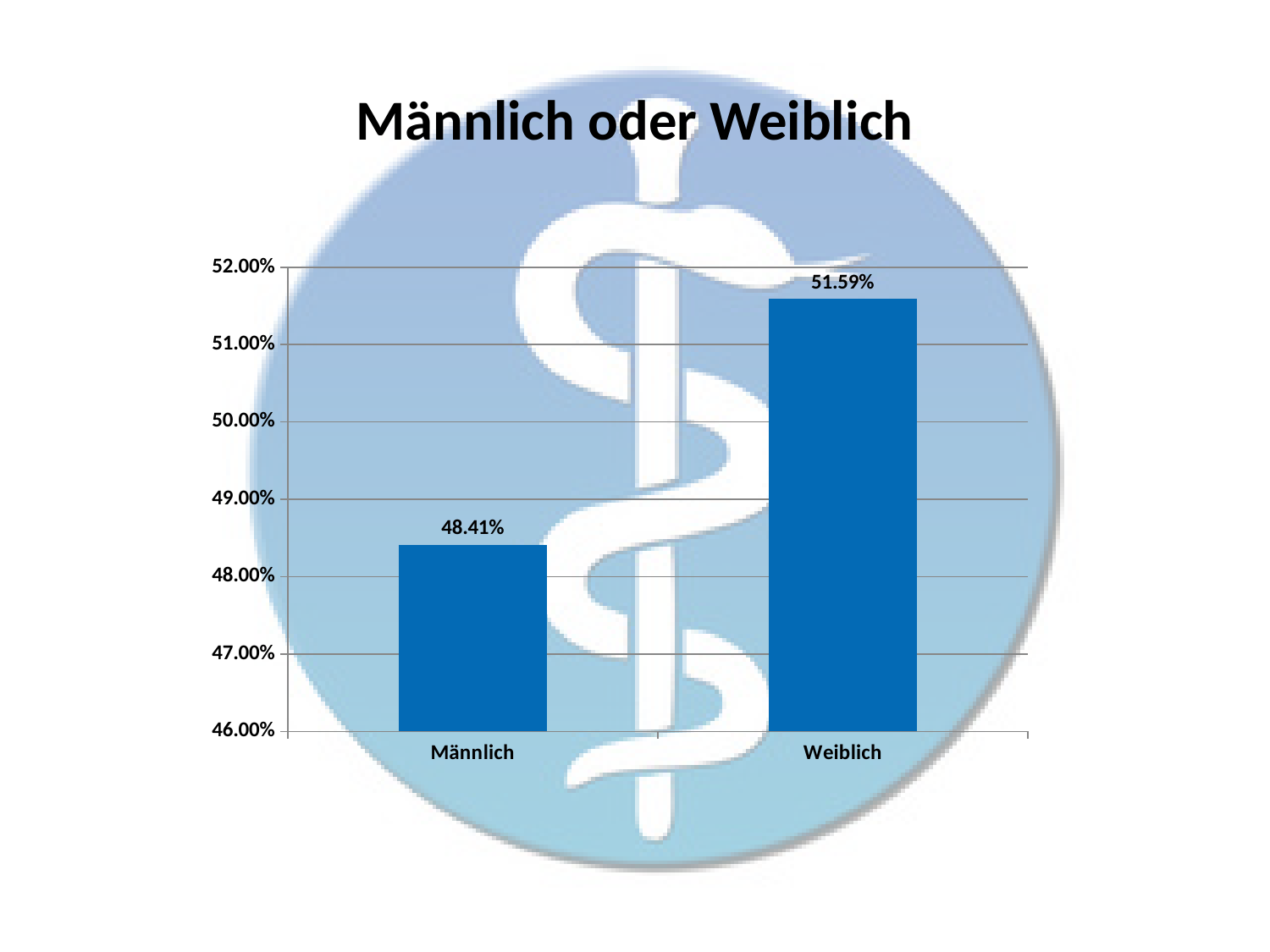
What is the value for Weiblich? 51.59% What kind of chart is shown on the slide? bar chart What is the value for Männlich? 48.41% Which category has the highest value? Weiblich Is the value for Männlich greater or less than 49.00%? less What is the title of the chart? Männlich oder Weiblich What is the lowest value shown on the y axis? 46.00% How many categories are shown on the x axis? 2 What is the difference between the values for Weiblich and Männlich? 3.18% Is the value for Weiblich greater or less than 51.00%? greater Which is larger, the value for Männlich or the value for Weiblich? Weiblich Which category has the lowest value? Männlich